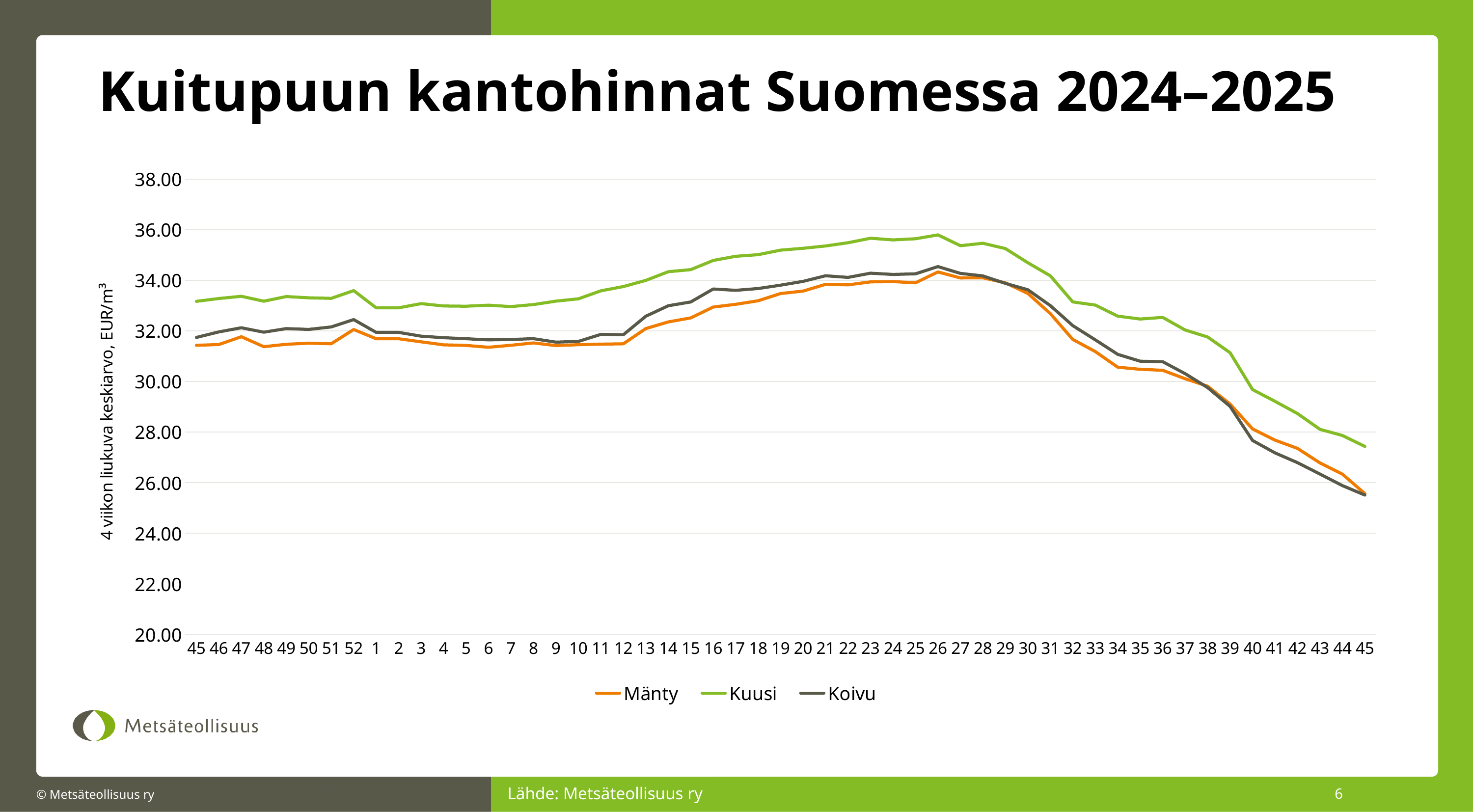
Which series are listed in the legend? Mänty, Kuusi, Koivu Is the value for Kuusi at week 26 greater or less than 34.00? greater Is the value for Kuusi at the last week 45 greater or less than 30.00? less Which series has the lowest value at week 16? Mänty How many week points are plotted along the x axis? 53 Which series has the highest value at week 26? Kuusi What kind of chart is shown on the slide? line chart What is the title of the chart? Kuitupuun kantohinnat Suomessa 2024–2025 Do the values for Kuusi rise or fall from week 26 to the final week 45? fall Which is higher at week 36, Kuusi or Koivu? Kuusi Is the value for Mänty at the first week 45 greater or less than 32.00? less How many series does the legend list? 3